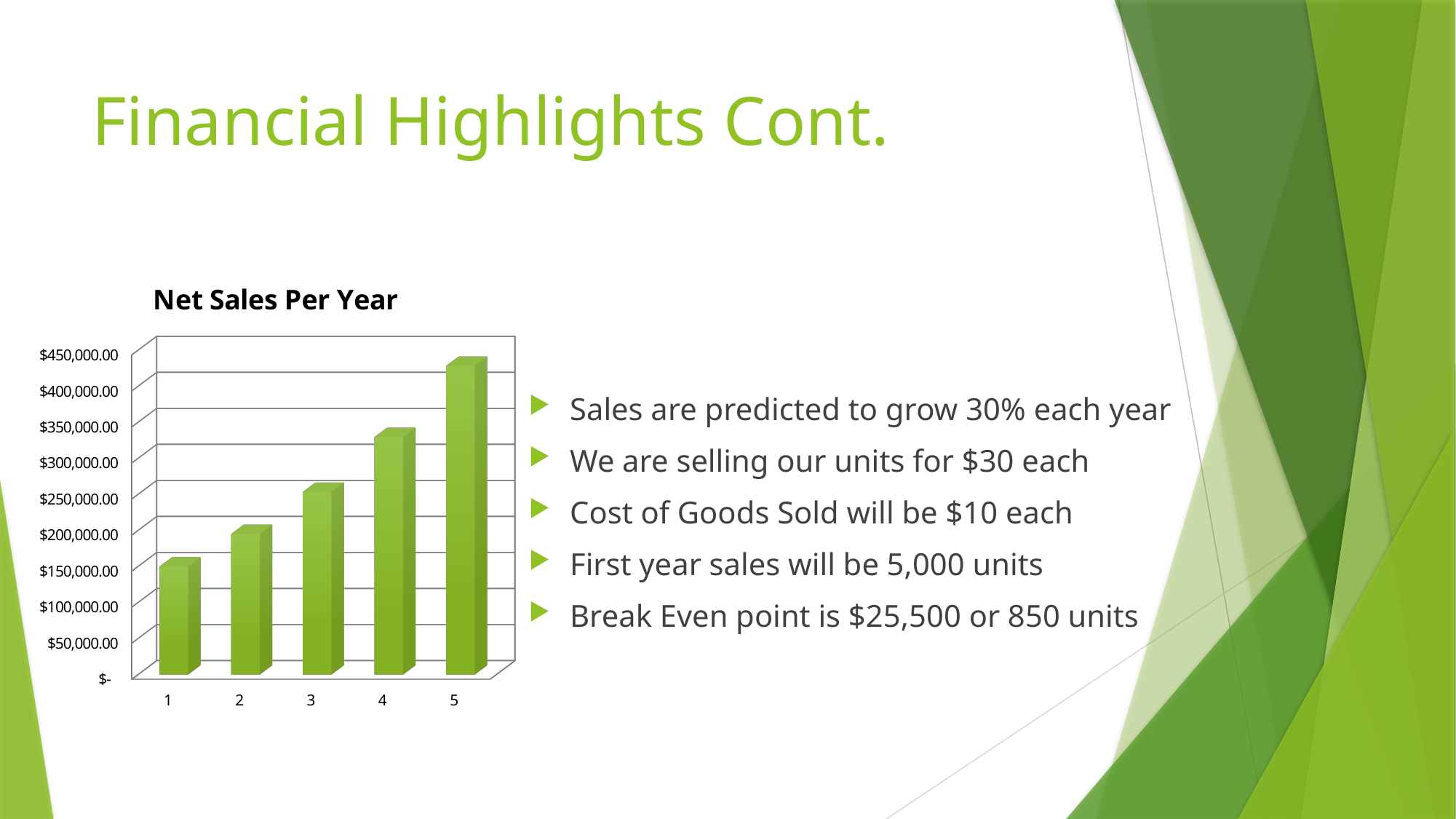
Which year has larger net sales, year 2 or year 4? 4 What is the title of the chart? Net Sales Per Year Which year has the highest net sales in the chart? 5 What type of chart is shown on the slide? bar chart How many bars (years) are plotted in the Net Sales Per Year chart? 5 Is the value for year 4 greater or less than $350,000.00? less Is the value for year 1 greater or less than $100,000.00? greater Is the value for year 3 greater or less than $200,000.00? greater Which year has the lowest net sales in the chart? 1 Do net sales rise or fall from year 1 to year 5 in the chart? rise